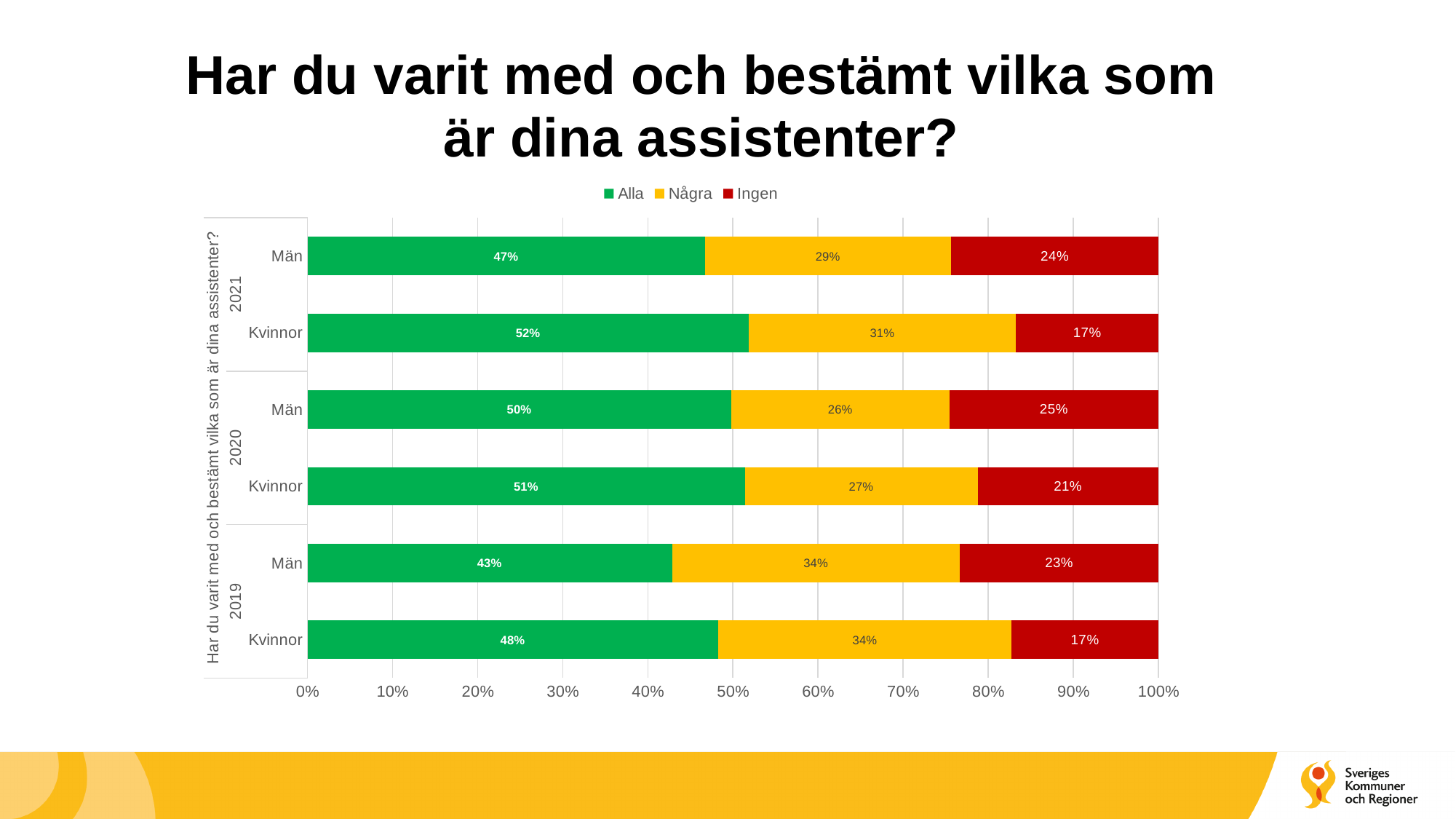
How many series does the legend list? 3 What percentage of men in 2021 answered "Alla"? 47% What percentage of women (Kvinnor) in 2019 answered "Några"? 34% What percentage of men in 2020 answered "Ingen"? 25% How many bars are shown in the chart? 6 Which colour represents the "Ingen" series? Red Which group and year has the highest share answering "Alla"? Kvinnor 2021 Which is larger: the "Ingen" share for men in 2020 or for women in 2020? Män 2020 What is the difference between the "Alla" share for women and men in 2021? 5 percentage points What kind of chart is shown on the slide? Stacked bar chart Which group and year has the lowest share answering "Alla"? Män 2019 Is the "Alla" share for men in 2019 greater or less than 50%? less